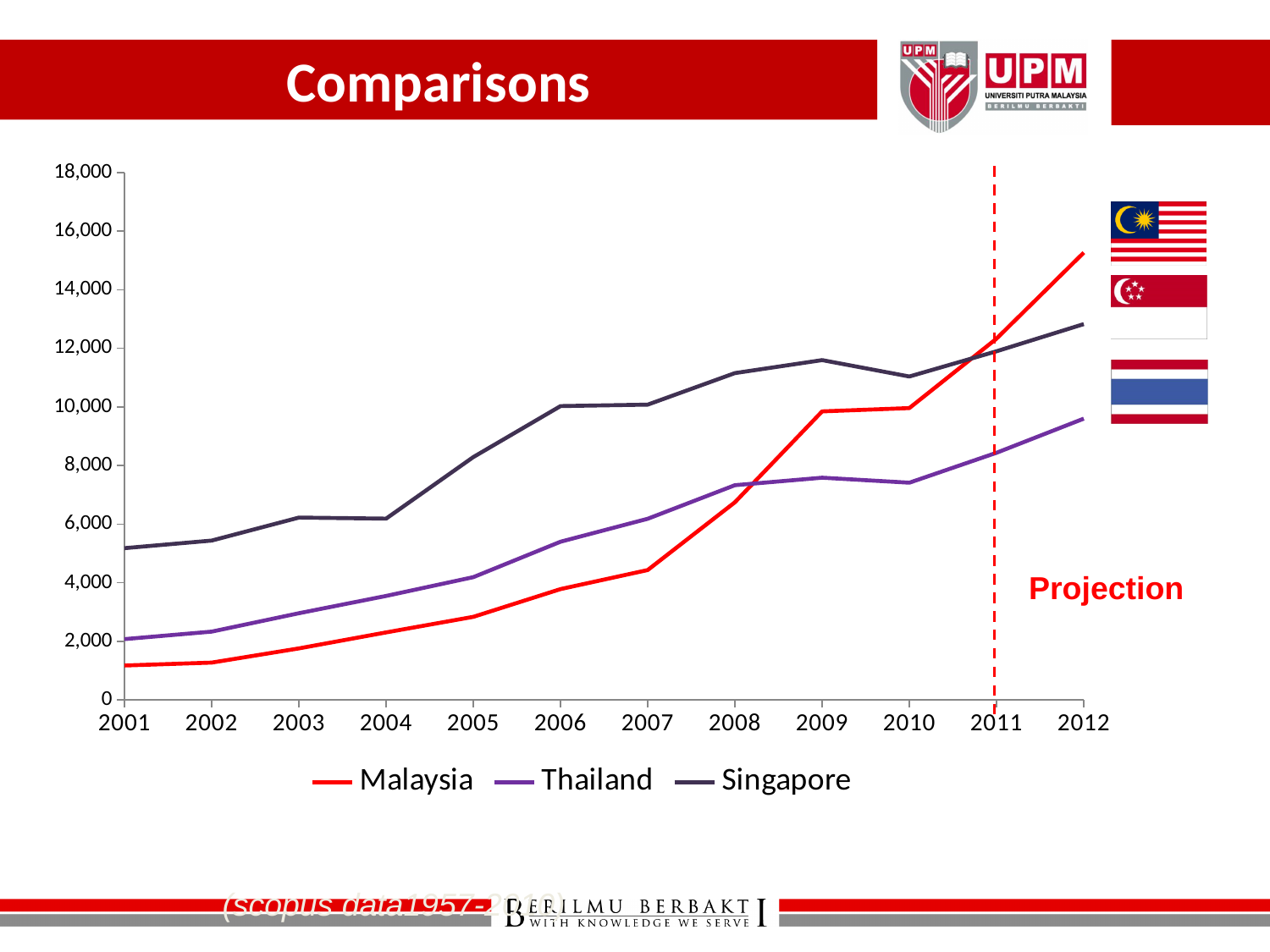
In 2012, which is higher: Malaysia or Singapore? Malaysia How many years are shown along the x axis? 12 Is the value for Malaysia in 2012 greater or less than 14,000? greater Is the value for Singapore in 2001 greater or less than 6,000? less Is the value for Thailand in 2012 greater or less than 10,000? less From which year onward does the chart mark the values as a projection? 2011 Which country has the lowest value in 2001? Malaysia In 2005, which is higher: Singapore or Thailand? Singapore Which country has the highest value in 2001? Singapore How many series does the legend list? 3 What kind of chart is shown on the slide? line chart Does the Malaysia line generally rise or fall from 2001 to 2012? rise